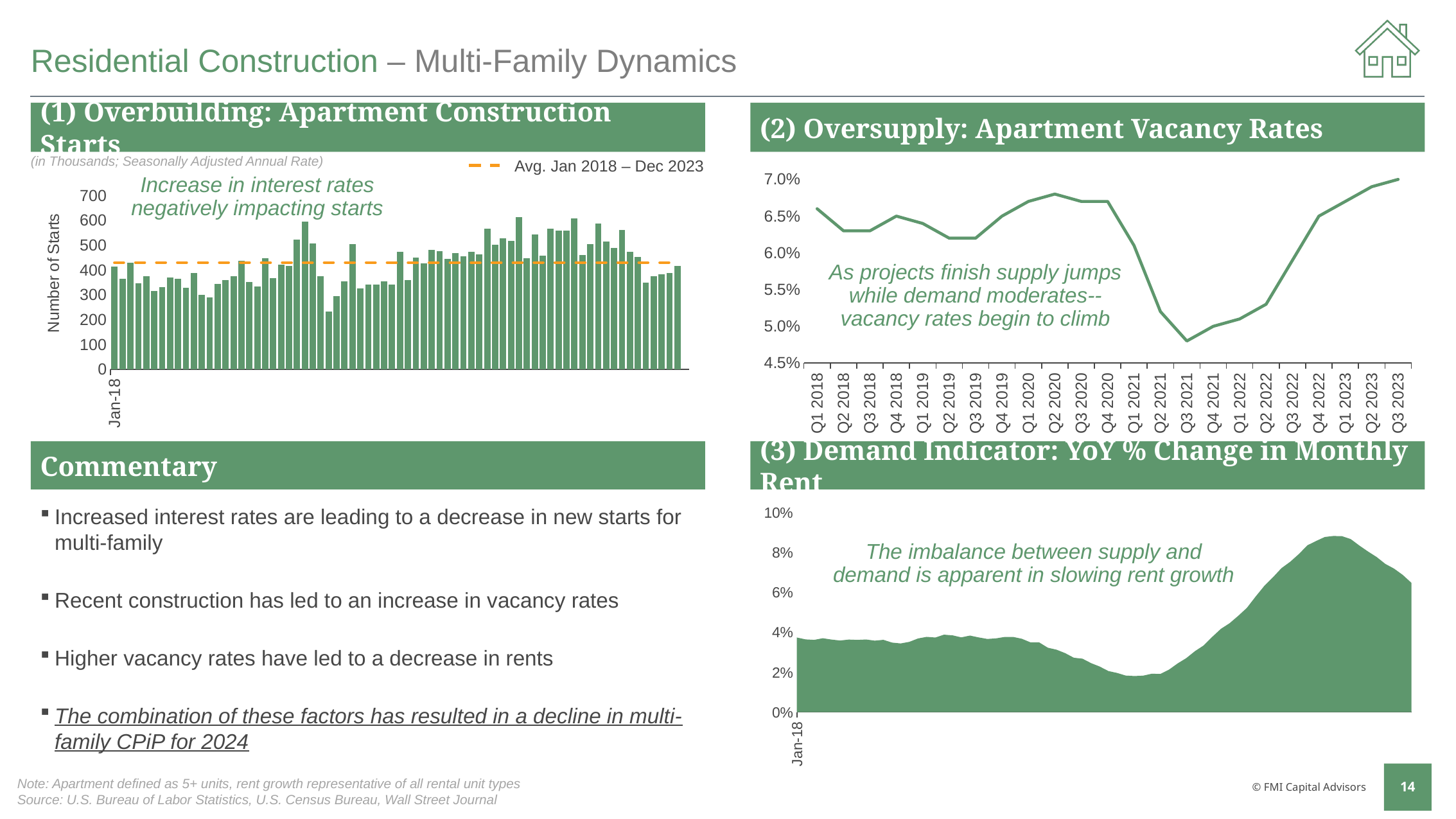
In the "(2) Oversupply: Apartment Vacancy Rates" chart, how many quarters are shown on the x axis? 23 In the "(2) Oversupply: Apartment Vacancy Rates" chart, which is larger, the value for Q2 2020 or the value for Q3 2021? Q2 2020 In the "(2) Oversupply: Apartment Vacancy Rates" chart, is the value for Q3 2021 greater or less than 5.0%? less In the "(2) Oversupply: Apartment Vacancy Rates" chart, is the value for Q2 2020 greater or less than 6.5%? greater What kind of chart is the "(2) Oversupply: Apartment Vacancy Rates" chart? Line chart In the "(2) Oversupply: Apartment Vacancy Rates" chart, which quarter has the highest vacancy rate? Q3 2023 What kind of chart is the "(1) Overbuilding: Apartment Construction Starts" chart? Bar chart In the "(3) Demand Indicator: YoY % Change in Monthly Rent" chart, is the highest value greater or less than 8%? greater What kind of chart is the "(3) Demand Indicator: YoY % Change in Monthly Rent" chart? Area chart In the "(2) Oversupply: Apartment Vacancy Rates" chart, do vacancy rates rise or fall from Q3 2021 to Q3 2023? Rise In the "(1) Overbuilding: Apartment Construction Starts" chart, what does the dashed orange line represent according to the legend? Avg. Jan 2018 – Dec 2023 In the "(2) Oversupply: Apartment Vacancy Rates" chart, which quarter has the lowest vacancy rate? Q3 2021